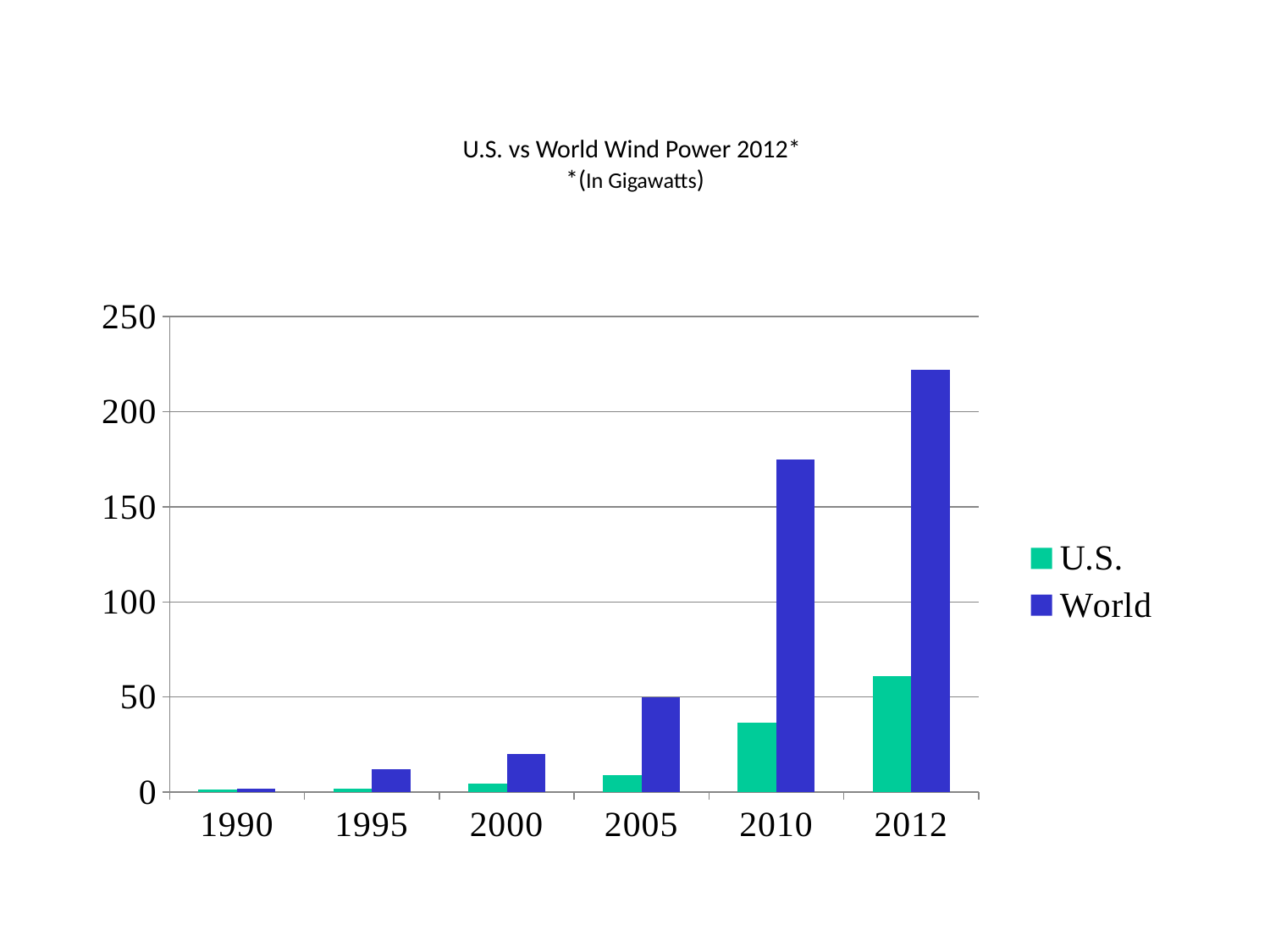
Which year has the highest World value? 2012 Do the World values rise or fall from 1990 to 2012? rise Which year has the lowest U.S. value? 1990 How many series does the legend list? 2 What kind of chart is shown on the slide? bar chart Is the U.S. value for 2012 greater or less than 50? greater Is the World value for 2012 greater or less than 200? greater Which is larger in 2005, the U.S. value or the World value? World How many years are shown on the x axis? 6 Is the U.S. value for 2010 greater or less than 50? less What unit does the chart title say the values are in? Gigawatts